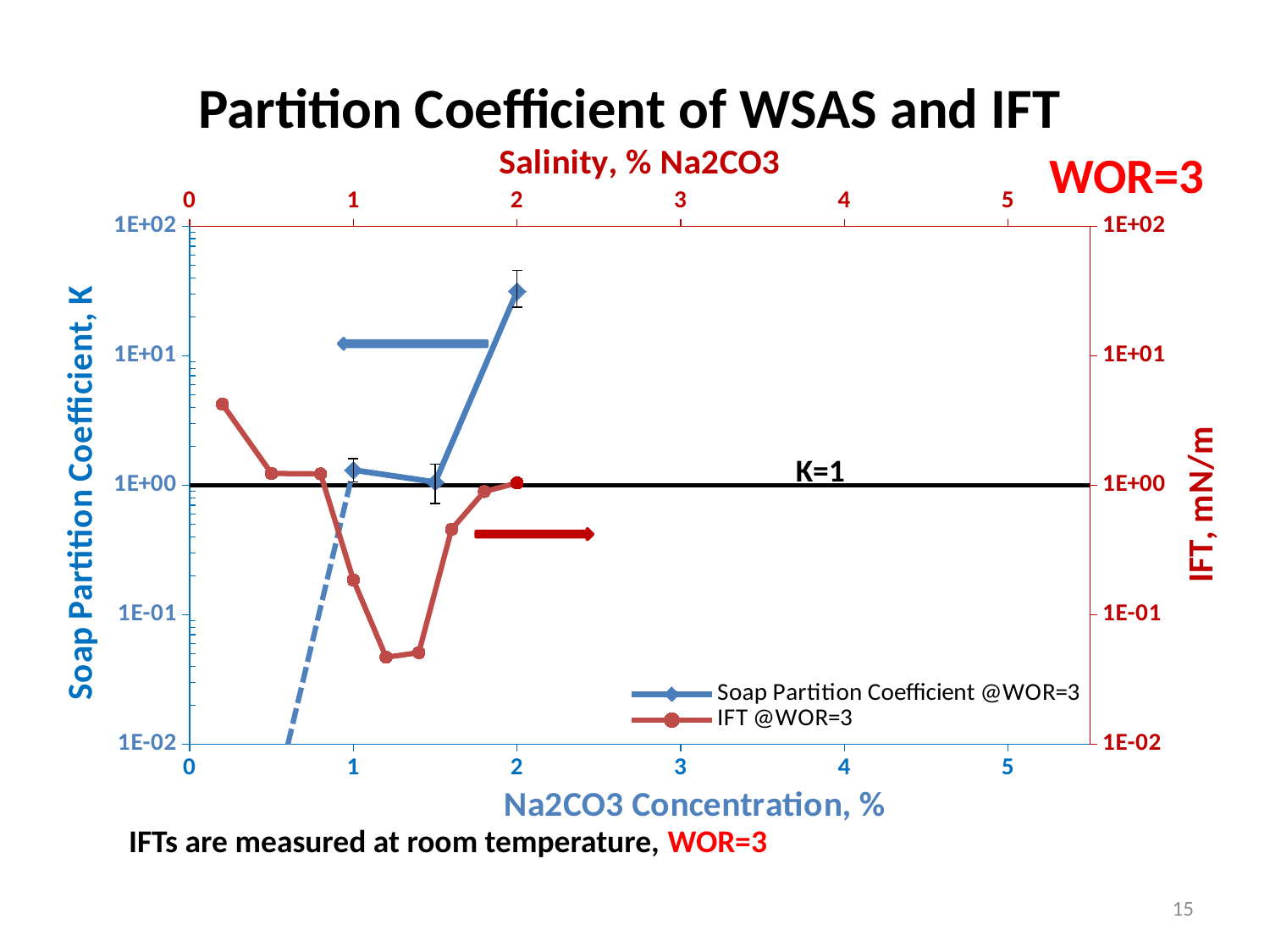
At which Na2CO3 concentration is the IFT highest? 0.2 What is the label on the horizontal black reference line? K=1 Is the IFT at 1% Na2CO3 greater or less than 1E+00? less How many data points are plotted for the IFT @WOR=3 series? 9 Is the Soap Partition Coefficient at 2% Na2CO3 greater or less than 1E+01? greater Does the IFT rise or fall as Na2CO3 concentration increases from 0.2% to 1.2%? fall Is the IFT at 1.2% Na2CO3 greater or less than 1E-01? less How many data points are plotted for the Soap Partition Coefficient @WOR=3 series? 3 At which Na2CO3 concentration is the Soap Partition Coefficient highest? 2 What kind of chart is shown on the slide? line chart How many series does the legend list? 2